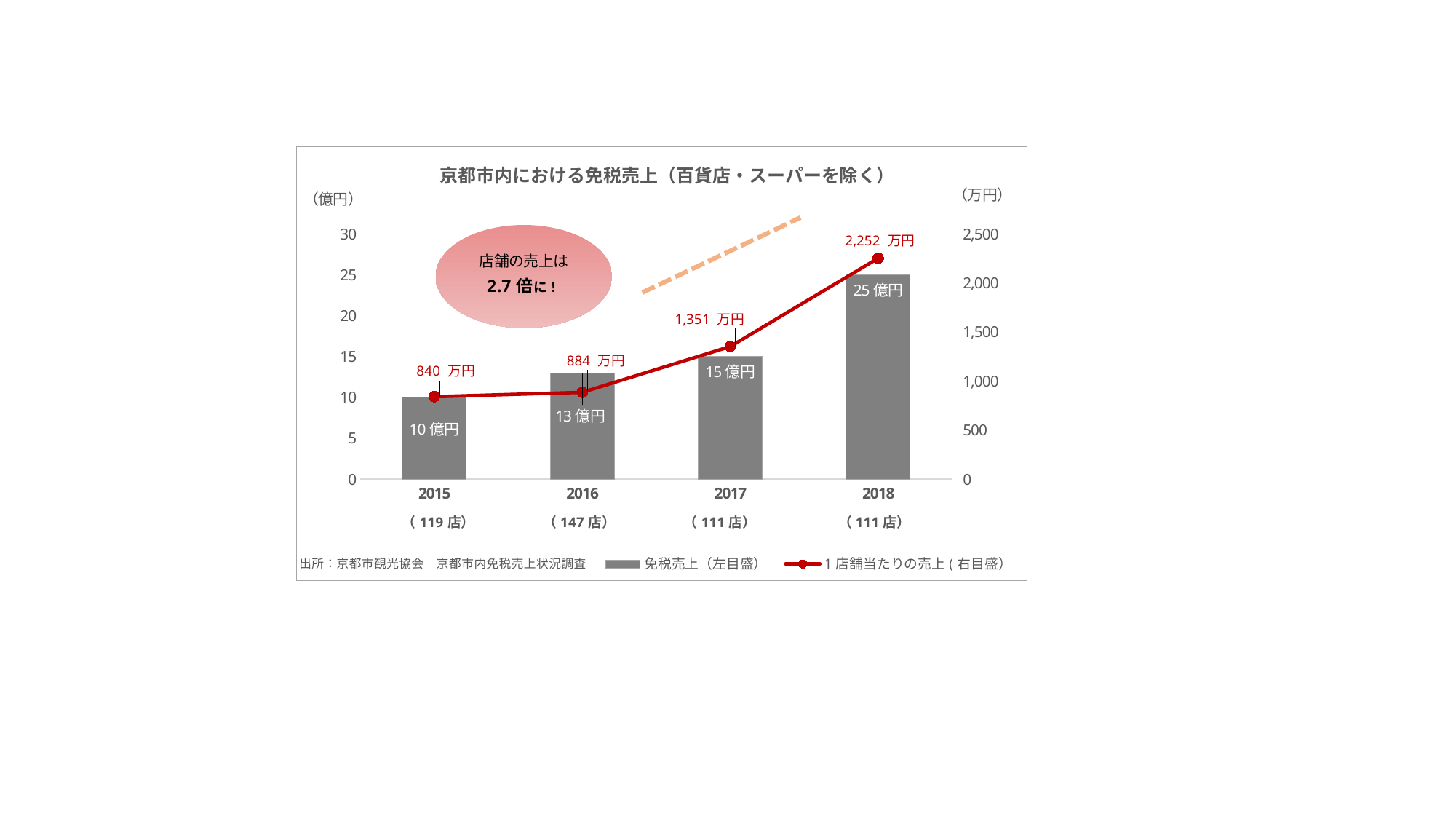
Does the 1店舗当たりの売上 line rise or fall from 2015 to 2018? rise How many years are shown on the x axis? 4 What is the 1店舗当たりの売上 value for 2015? 840 万円 Which year has the lowest 1店舗当たりの売上? 2015 What is the 免税売上 (bar) value for 2018? 25 億円 Which year has the larger 免税売上, 2016 or 2017? 2017 What is the difference in 免税売上 between 2018 and 2015? 15 億円 What is the title of the chart? 京都市内における免税売上（百貨店・スーパーを除く） Which year has the highest 免税売上? 2018 What is the 1店舗当たりの売上 (line) value for 2017? 1,351 万円 What is the difference in 1店舗当たりの売上 between 2016 and 2015? 44 万円 How many series does the legend list? 2